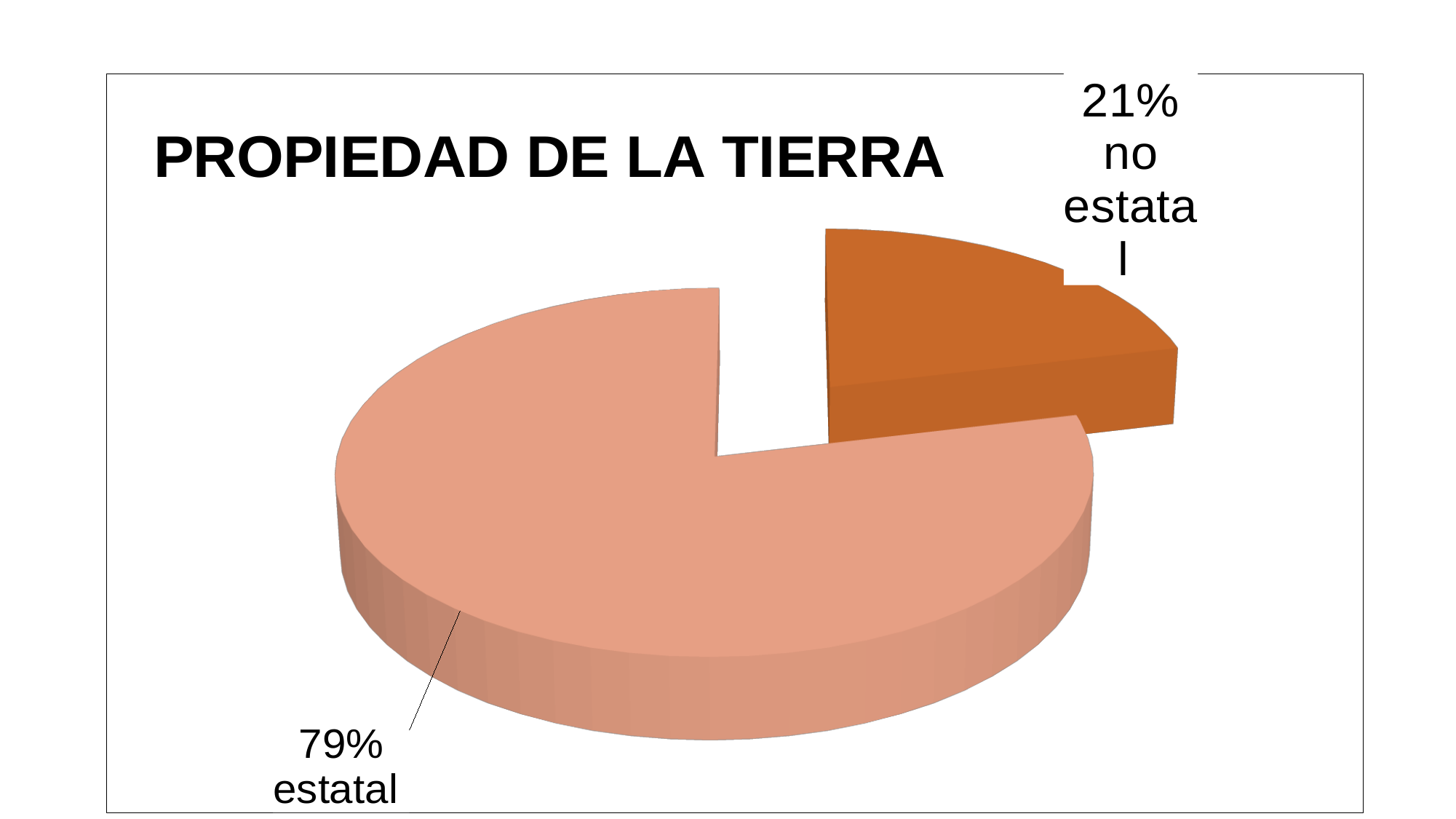
Which is larger, the 'estatal' slice or the 'no estatal' slice? estatal How many slices does the pie chart have? 2 What percentage of the pie is labelled 'no estatal'? 21% What percentage of the pie is labelled 'estatal'? 79% What share of the pie does the 'no estatal' slice represent? 21% Which slice of the pie is the smallest? no estatal What is the title of the chart? PROPIEDAD DE LA TIERRA Which slice of the pie is the largest? estatal What kind of chart is shown on the slide? pie chart Which slice is pulled out (exploded) from the pie? no estatal What is the difference in percentage points between the 'estatal' and 'no estatal' slices? 58